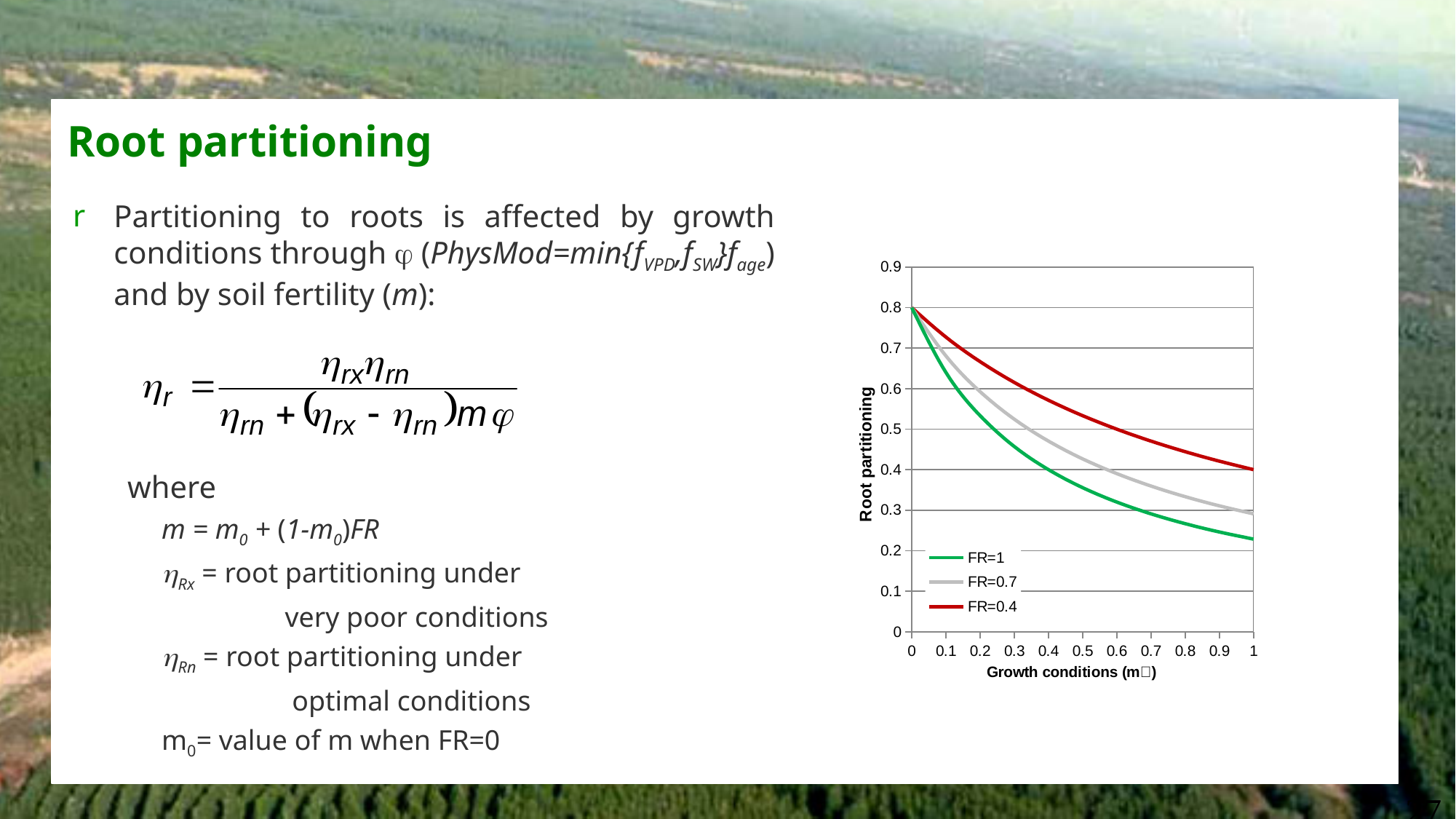
Which series has the lowest root partitioning at growth conditions of 1? FR=1 Which series is drawn in green in the chart? FR=1 Which series has the highest root partitioning at growth conditions of 0.5? FR=0.4 What is the root partitioning value for FR=0.4 at growth conditions of 1? 0.4 What is the title of the chart's y axis? Root partitioning Do the root partitioning values rise or fall as growth conditions increase along the x axis? fall At growth conditions of 1, is the root partitioning for FR=1 greater or less than 0.2? greater At growth conditions of 0.5, is the root partitioning for FR=1 greater or less than 0.4? less How many series does the chart legend list? 3 At growth conditions of 0.3, which is larger: the root partitioning for FR=0.7 or for FR=1? FR=0.7 What kind of chart is shown on the slide? line chart What is the root partitioning value for all three series at growth conditions of 0? 0.8